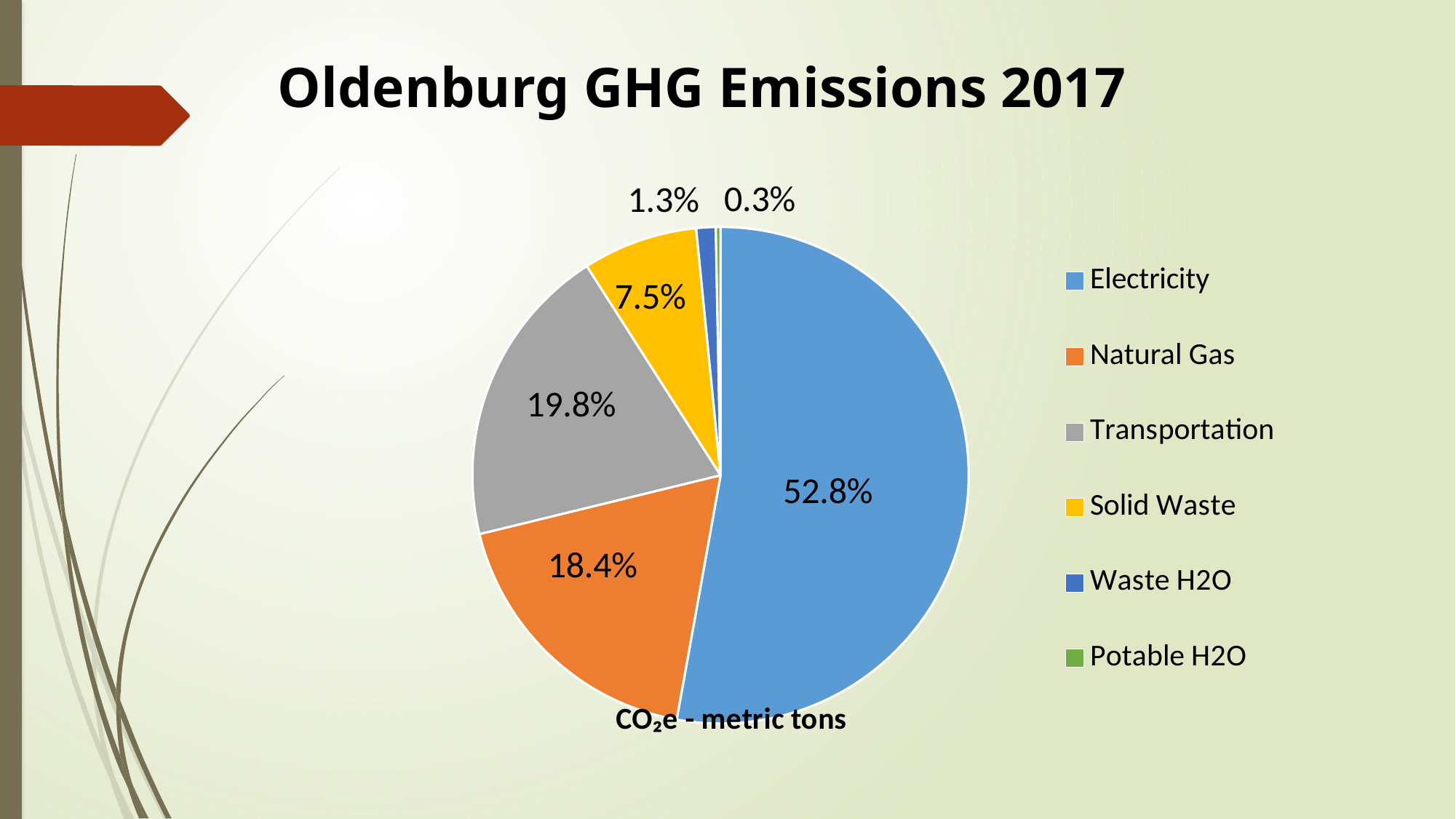
What share of the pie does Natural Gas account for? 18.4% What share of the pie does Electricity account for? 52.8% What share of the pie does Waste H2O account for? 1.3% What is the title of the chart on the slide? CO₂e - metric tons Which category has the smallest share of emissions? Potable H2O Which category has the largest share of emissions? Electricity What kind of chart is shown on the slide? Pie chart What is the difference in percentage points between Transportation and Natural Gas? 1.4 Which is larger, the share for Solid Waste or the share for Waste H2O? Solid Waste How many categories does the pie chart show? 6